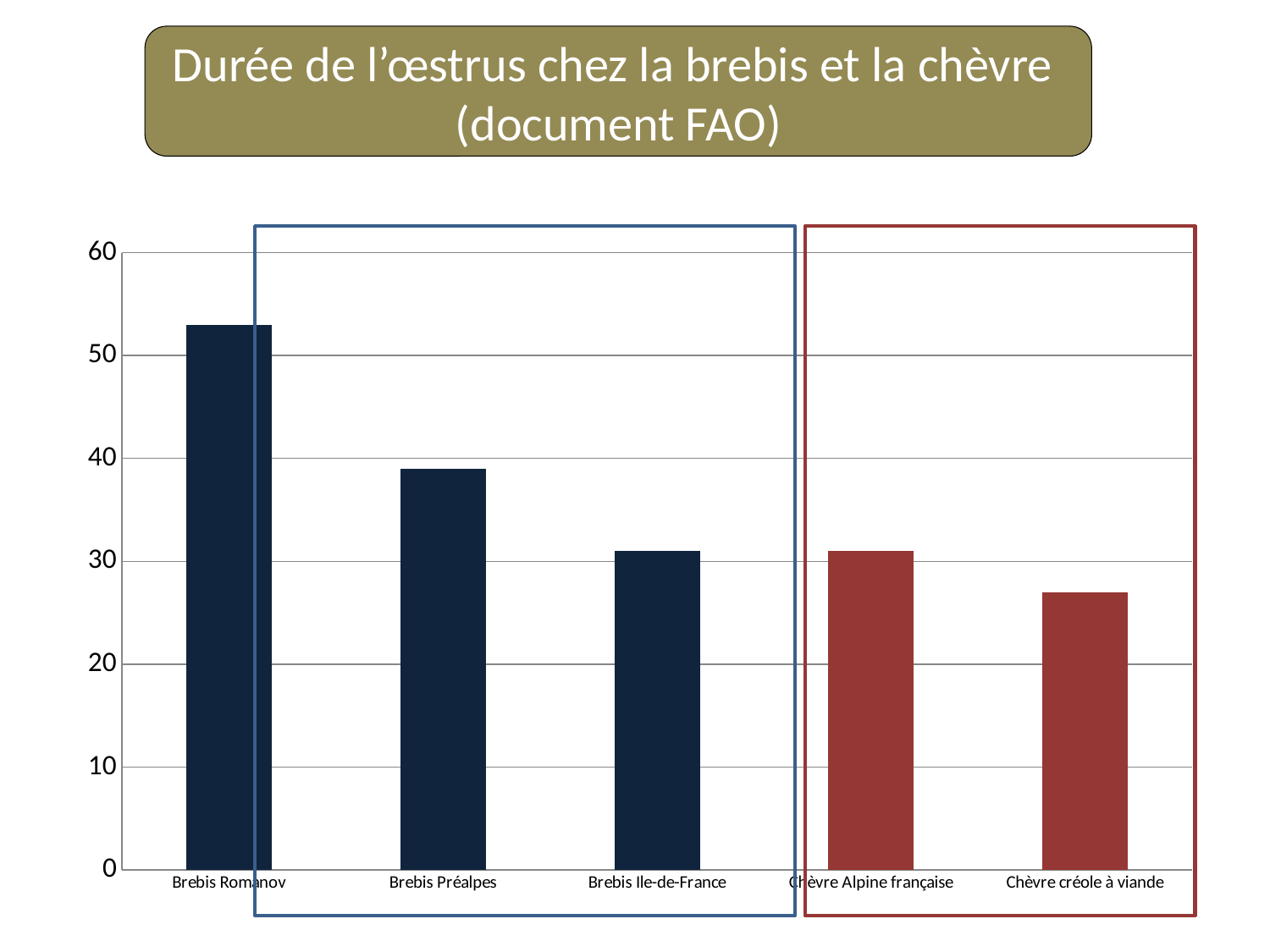
Which category has the lowest value in the chart? Chèvre créole à viande Which is larger, the value for Brebis Romanov or the value for Chèvre Alpine française? Brebis Romanov Is the value for Chèvre créole à viande greater or less than 30? less Do the bar values generally rise or fall from left to right across the chart? fall Is the value for Chèvre créole à viande greater or less than 20? greater What kind of chart is shown on the slide? bar chart Which is larger, the value for Brebis Préalpes or the value for Brebis Ile-de-France? Brebis Préalpes What is the title shown above the chart on the slide? Durée de l'œstrus chez la brebis et la chèvre (document FAO) How many categories are shown on the x axis of the chart? 5 Is the value for Brebis Romanov greater or less than 50? greater Which category has the highest value in the chart? Brebis Romanov